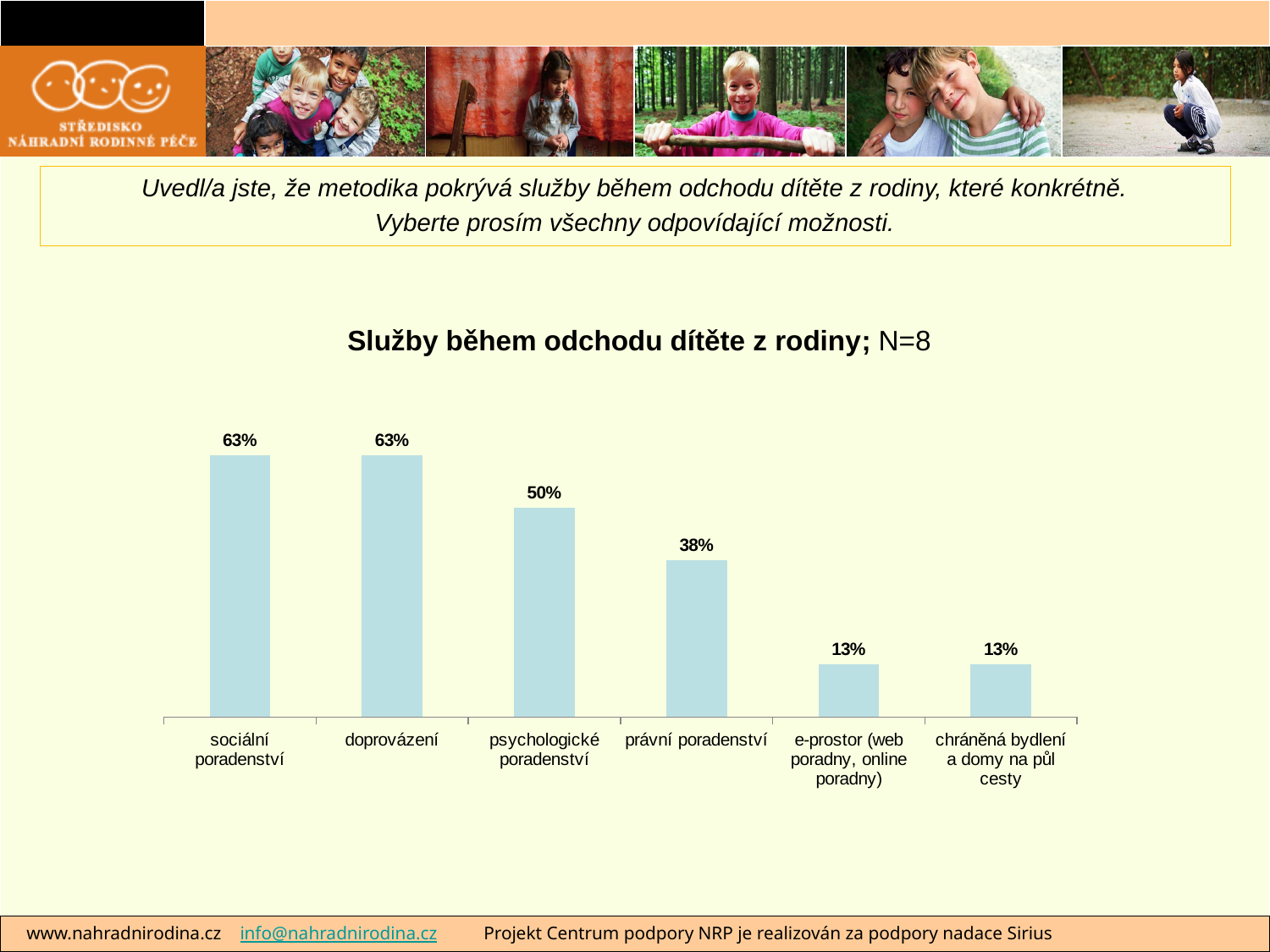
What is the lowest value shown in the chart? 13% What is the value for e-prostor (web poradny, online poradny)? 13% What is the value for psychologické poradenství? 50% What is the value for chráněná bydlení a domy na půl cesty? 13% What is the title of the chart? Služby během odchodu dítěte z rodiny; N=8 What is the difference between the values for doprovázení and právní poradenství? 25% How many categories are shown in the chart? 6 What is the value for sociální poradenství? 63% What is the value for právní poradenství? 38% Which is larger, the value for psychologické poradenství or the value for právní poradenství? psychologické poradenství What is the highest value shown in the chart? 63% What kind of chart is shown on the slide? bar chart